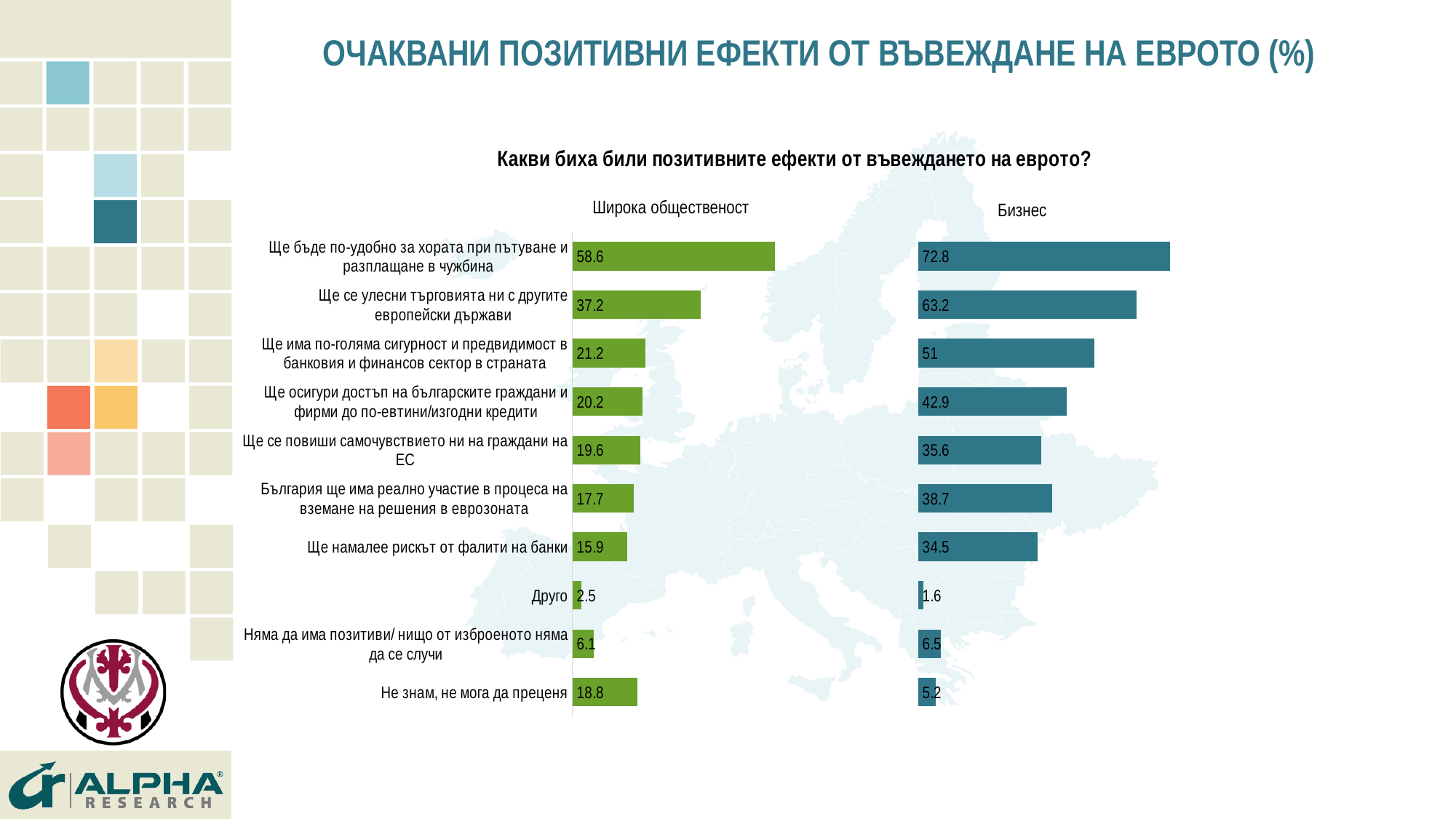
In the "Широка общественост" chart, what is the value for "Ще намалее рискът от фалити на банки"? 15.9 What is the difference between the "Бизнес" value and the "Широка общественост" value for "Ще осигури достъп на българските граждани и фирми до по-евтини/изгодни кредити"? 22.7 In the "Бизнес" chart, what is the value for "Не знам, не мога да преценя"? 5.2 In the "Широка общественост" chart, what is the value for "Ще бъде по-удобно за хората при пътуване и разплащане в чужбина"? 58.6 Which chart has the larger value for "Не знам, не мога да преценя": "Широка общественост" or "Бизнес"? Широка общественост In the "Широка общественост" chart, which category has the highest value? Ще бъде по-удобно за хората при пътуване и разплащане в чужбина How many categories are shown in the "Широка общественост" chart? 10 In the "Бизнес" chart, what is the value for "Ще има по-голяма сигурност и предвидимост в банковия и финансов сектор в страната"? 51 In the "Бизнес" chart, which category has the lowest value? Друго What type of chart is used on this slide? Bar chart What is the difference between the "Бизнес" value and the "Широка общественост" value for "Ще се улесни търговията ни с другите европейски държави"? 26 In the "Бизнес" chart, which is larger: "Ще се повиши самочувствието ни на граждани на ЕС" or "България ще има реално участие в процеса на вземане на решения в еврозоната"? България ще има реално участие в процеса на вземане на решения в еврозоната